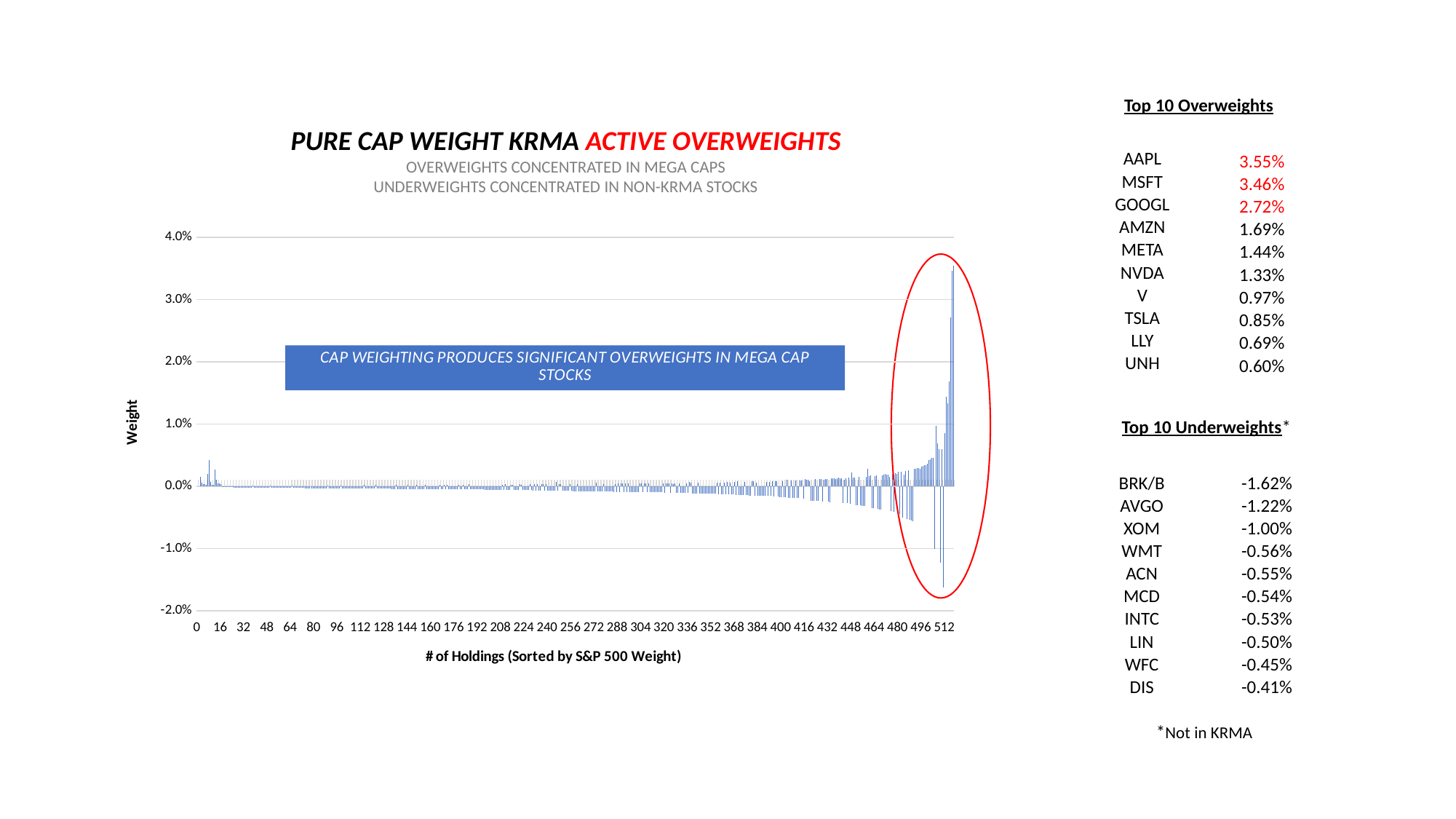
Is the value of the tallest bar in the chart greater or less than 3.0%? greater What is the title of the chart's x axis? # of Holdings (Sorted by S&P 500 Weight) What is the title of the chart's y axis? Weight What kind of chart is shown on the slide? bar chart At which end of the x axis, left or right, is the highest bar located? right Is the value of the lowest bar in the chart greater or less than -2.0%? greater Is the value of the tallest bar in the chart greater or less than 4.0%? less